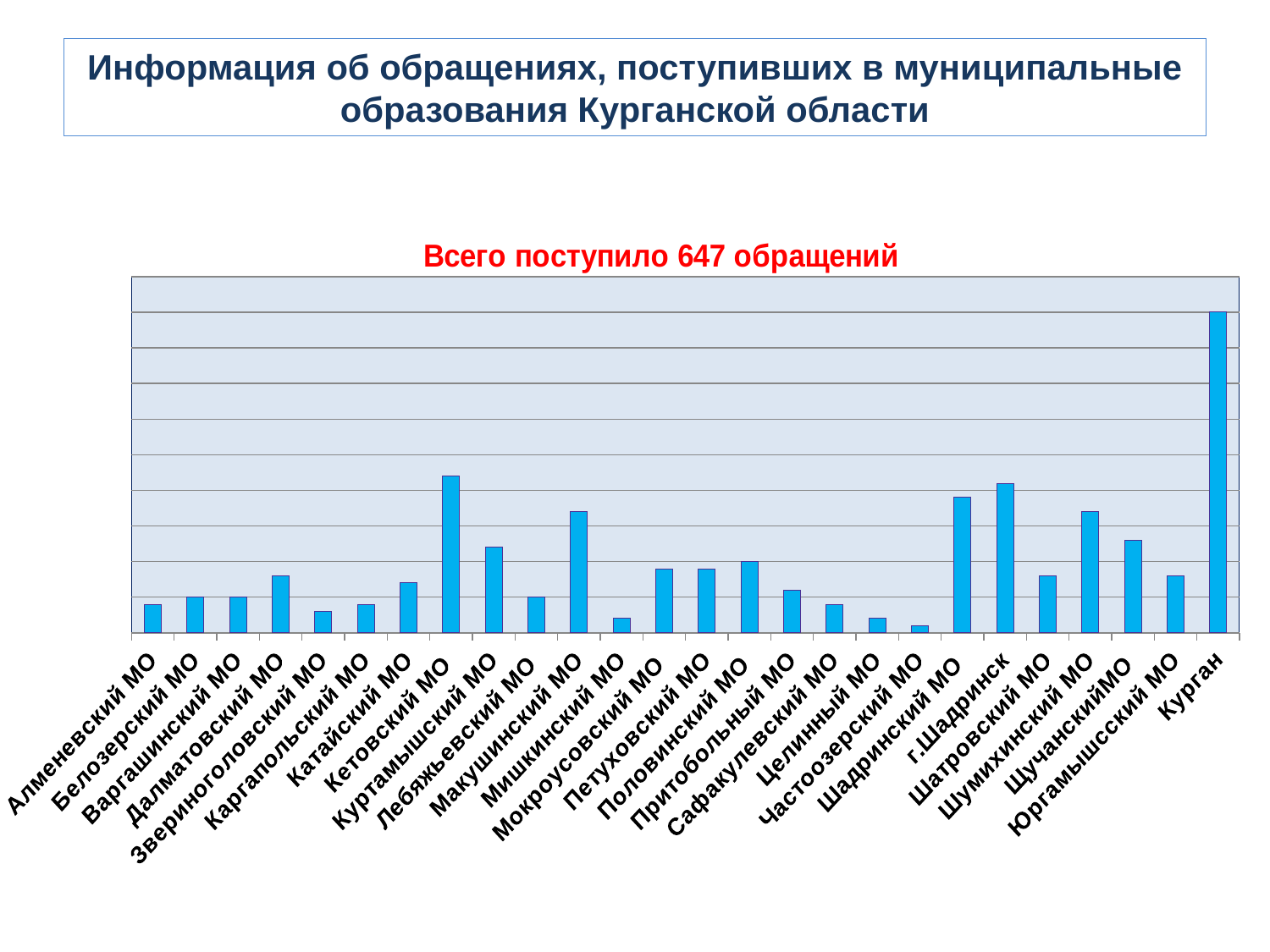
Which has the larger value, Шумихинский МО or ЩучанскийМО? Шумихинский МО Which category has the lowest bar in the chart? Частоозерский МО Which has the larger value, Далматовский МО or Звериноголовский МО? Далматовский МО What is the title of the chart shown above the plot area? Всего поступило 647 обращений How many municipalities (categories) are shown on the x axis of the chart? 26 What kind of chart is shown on the slide? bar chart Which category has the highest bar in the chart? Курган According to the chart's subtitle, how many appeals were received in total? 647 Which has the larger value, Куртамышский МО or Притобольный МО? Куртамышский МО